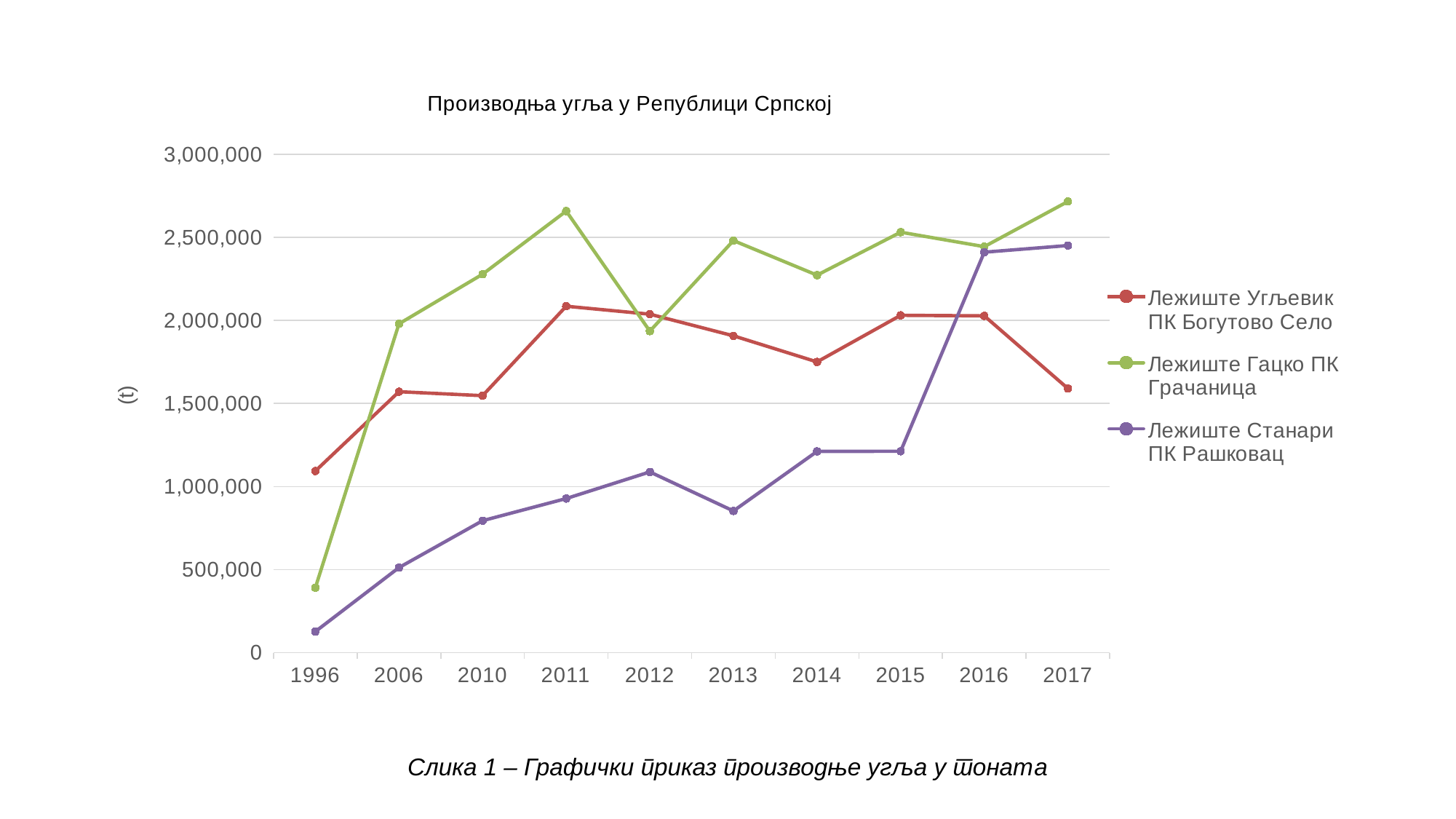
In 2016, which is larger: Лежиште Станари ПК Рашковац or Лежиште Угљевик ПК Богутово Село? Лежиште Станари ПК Рашковац In which year does Лежиште Станари ПК Рашковац have its lowest value? 1996 Is the value for Лежиште Гацко ПК Грачаница in 2017 greater or less than 2,500,000? greater What kind of chart is shown on the slide? Line chart How many years are shown on the x axis? 10 What is the title of the chart? Производња угља у Републици Српској In which year does Лежиште Гацко ПК Грачаница reach its highest value? 2017 How many series does the legend list? 3 Is the value for Лежиште Станари ПК Рашковац in 2013 greater or less than 1,000,000? less Is the value for Лежиште Станари ПК Рашковац in 1996 greater or less than 500,000? less Which series has the highest value in 2017? Лежиште Гацко ПК Грачаница